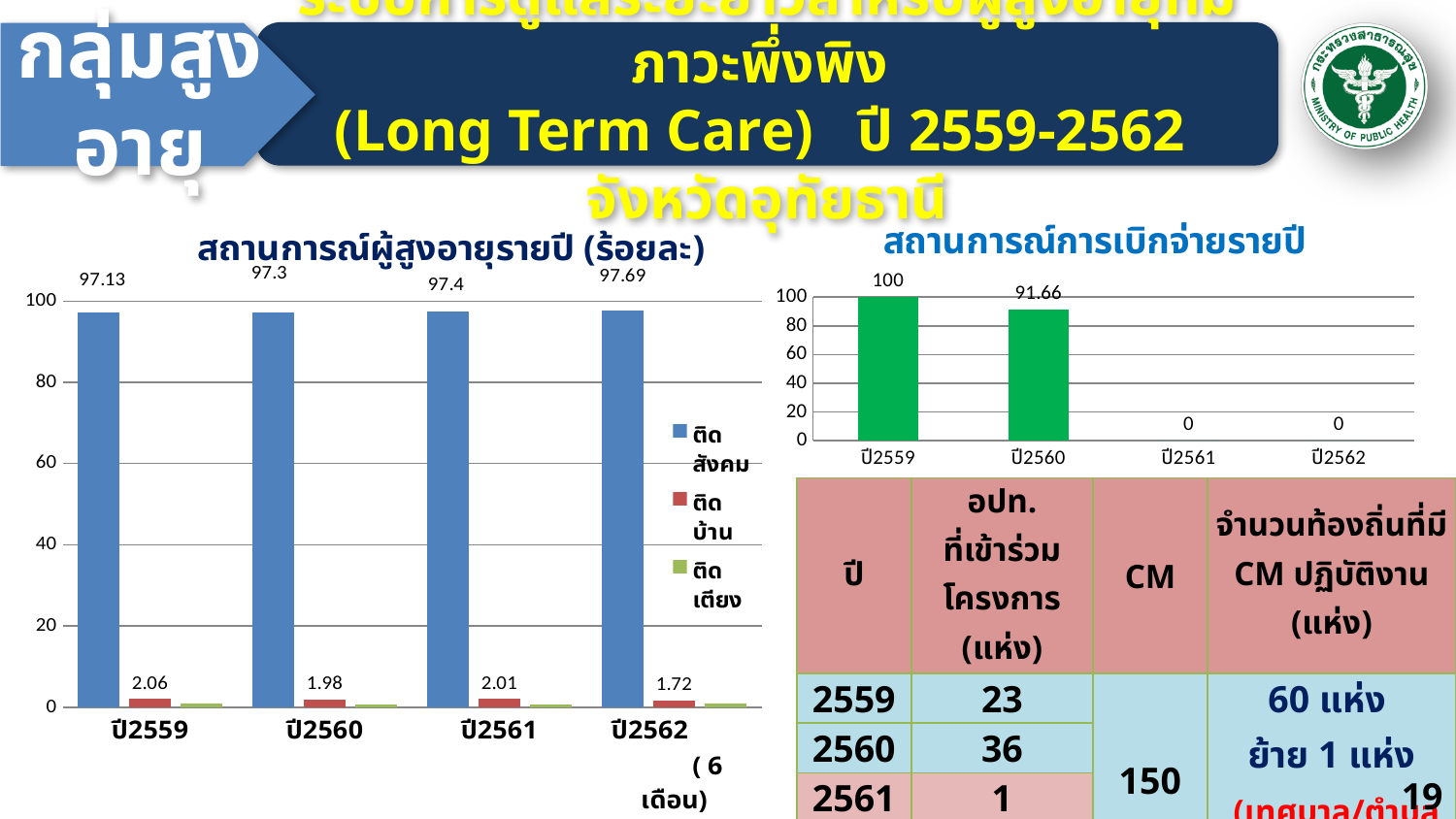
In the chart titled สถานการณ์ผู้สูงอายุรายปี (ร้อยละ), which year has the lowest ติดบ้าน value? ปี2562 In the chart titled สถานการณ์การเบิกจ่ายรายปี, what is the value for ปี2561? 0 In the chart titled สถานการณ์ผู้สูงอายุรายปี (ร้อยละ), what is the value of ติดบ้าน for ปี2562? 1.72 In the chart titled สถานการณ์การเบิกจ่ายรายปี, what is the value for ปี2560? 91.66 In the chart titled สถานการณ์ผู้สูงอายุรายปี (ร้อยละ), what is the difference between the ติดบ้าน values for ปี2559 and ปี2562? 0.34 In the chart titled สถานการณ์ผู้สูงอายุรายปี (ร้อยละ), what is the value of ติดสังคม for ปี2559? 97.13 In the chart titled สถานการณ์การเบิกจ่ายรายปี, which year has the highest value? ปี2559 In the chart titled สถานการณ์ผู้สูงอายุรายปี (ร้อยละ), does the ติดสังคม value rise or fall from ปี2559 to ปี2562? rise What kind of chart is the chart titled สถานการณ์การเบิกจ่ายรายปี? bar chart In the chart titled สถานการณ์ผู้สูงอายุรายปี (ร้อยละ), how many series does the legend list? 3 In the chart titled สถานการณ์ผู้สูงอายุรายปี (ร้อยละ), which year has the highest ติดสังคม value? ปี2562 In the chart titled สถานการณ์การเบิกจ่ายรายปี, what is the difference between the values for ปี2559 and ปี2560? 8.34